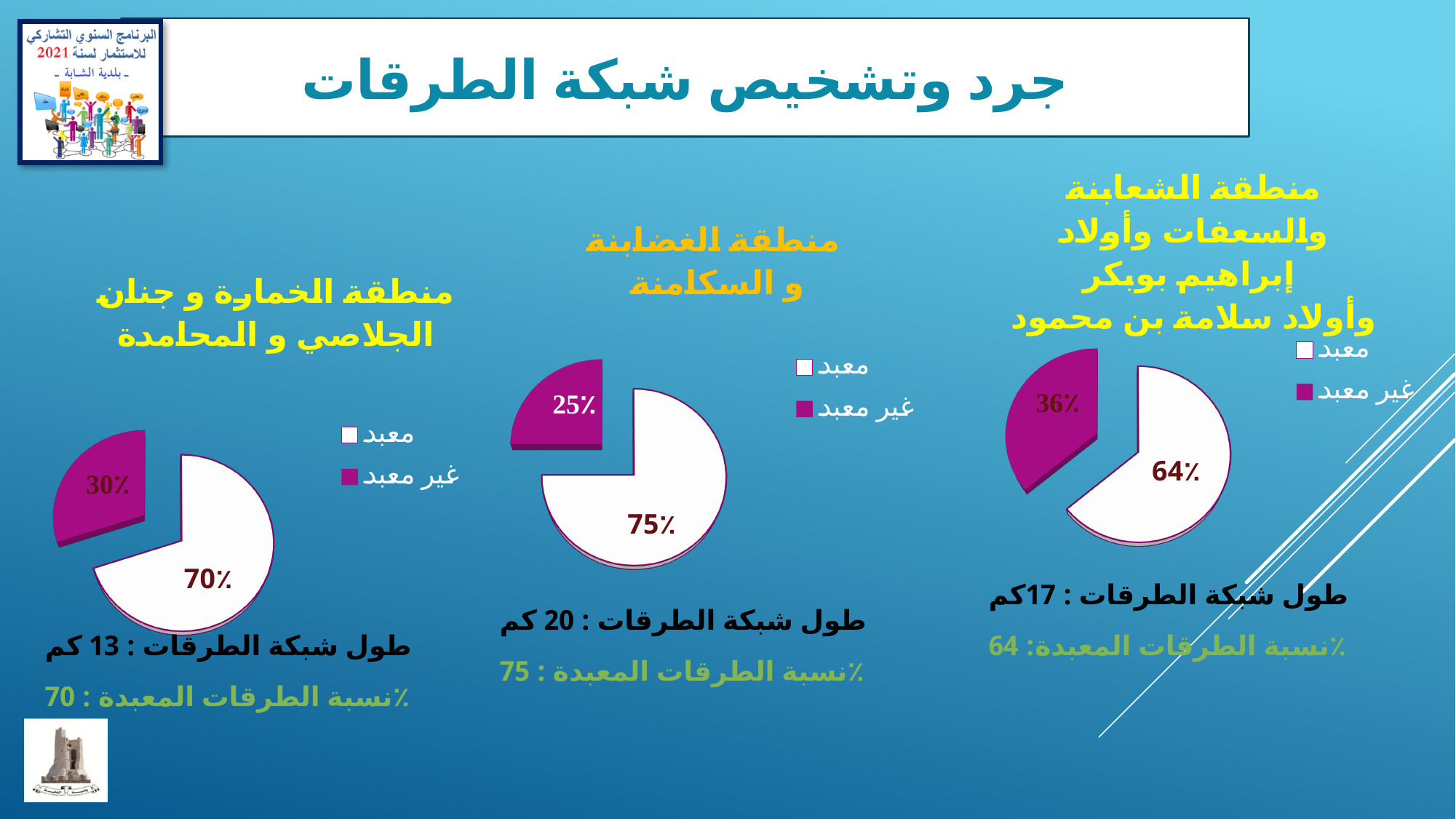
In the right pie chart (منطقة الشعابنة والسعفات وأولاد إبراهيم بوبكر وأولاد سلامة بن محمود), what share is labelled غير معبد? 36% In the pie charts, which colour represents غير معبد? Magenta (purple) In the left pie chart (منطقة الخمارة و جنان الجلاصي و المحامدة), what share is labelled غير معبد? 30% How many entries does the legend of the left pie chart list? 2 What kind of chart is used for each of the three regions on the slide? Pie chart In the right pie chart (منطقة الشعابنة والسعفات وأولاد إبراهيم بوبكر وأولاد سلامة بن محمود), what share is labelled معبد? 64% In the middle pie chart (منطقة الغضابنة و السكامنة), what share is labelled معبد? 75% How many slices does each pie chart on the slide have? 2 In the middle pie chart (منطقة الغضابنة و السكامنة), which slice is larger, معبد or غير معبد? معبد In the middle pie chart (منطقة الغضابنة و السكامنة), what share is labelled غير معبد? 25% In the right pie chart, what is the difference between the معبد share and the غير معبد share? 28% In the left pie chart (منطقة الخمارة و جنان الجلاصي و المحامدة), what share is labelled معبد? 70%